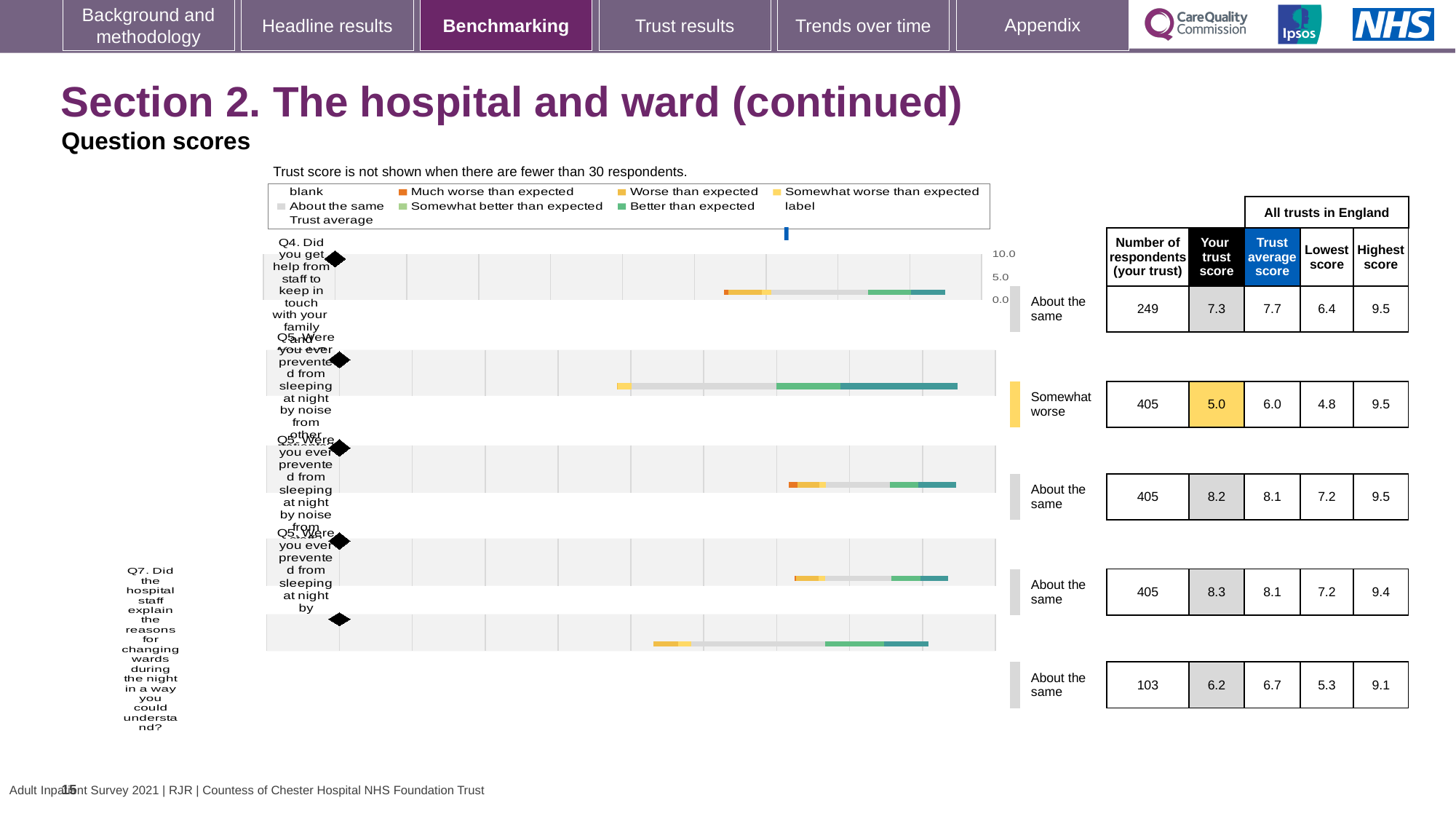
How many question rows are plotted in the chart? 5 What is the 'Your trust score' for Q4 (help from staff to keep in touch with family and friends)? 7.3 What is the 'Your trust score' for Q7? 6.2 What is the difference between the trust average score and your trust score for Q4? 0.4 What is the 'Your trust score' for the question rated 'Somewhat worse'? 5.0 Is the 'Your trust score' for Q7 greater or less than 5.0? greater What is the difference between the highest score and the lowest score across all trusts in England for Q7? 3.8 How many respondents answered Q4? 249 For Q7, which is larger: your trust score or the trust average score? Trust average score Which question has the lowest number of respondents? Q7 What kind of chart is used to show the question scores on this slide? bar chart What is the trust average score for Q7 (explaining reasons for changing wards during the night)? 6.7